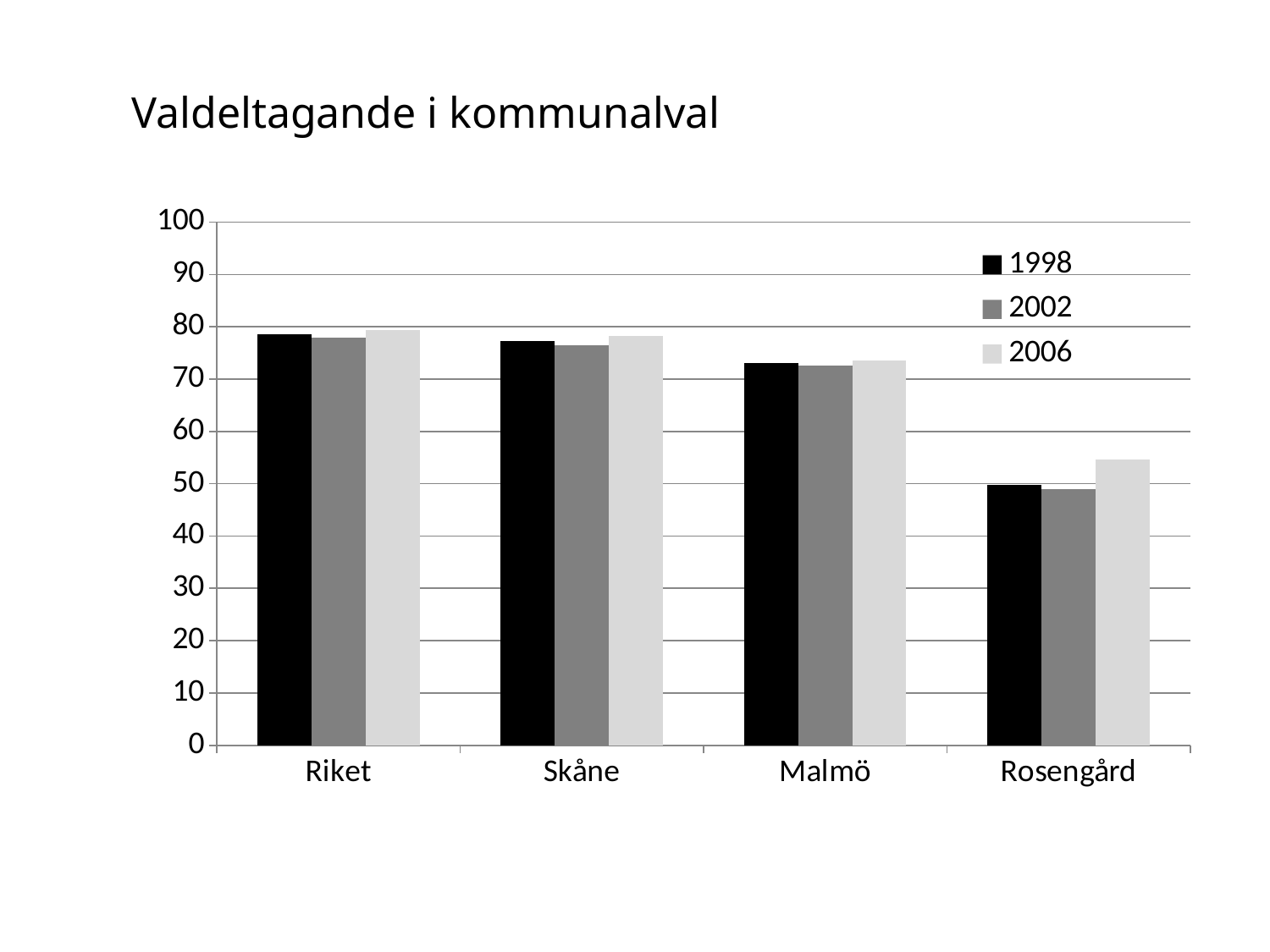
Is the value for Rosengård in 1998 greater or less than 60? less How many series does the legend list? 3 Which category has the lowest value for 2006? Rosengård What kind of chart is shown on the slide? bar chart Is the value for Skåne in 2002 greater or less than 70? greater What is the title of the chart? Valdeltagande i kommunalval Which category has the lowest value for 1998? Rosengård Is the value for Malmö in 1998 greater or less than 70? greater For Rosengård, which is larger: the value for 2002 or the value for 2006? 2006 How many categories are shown on the x axis? 4 Do the values for 2006 rise or fall moving from Riket to Rosengård along the x axis? fall